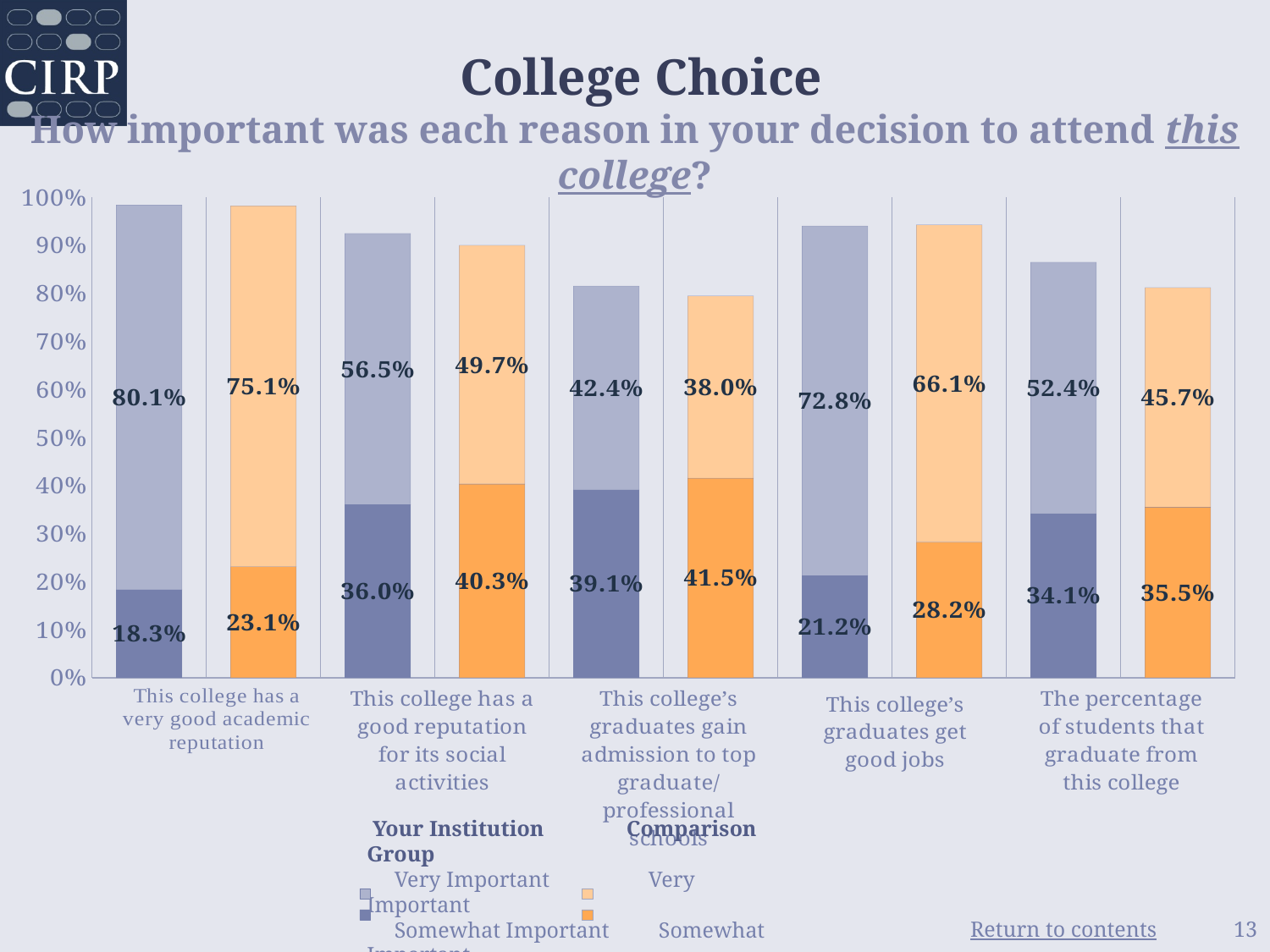
For 'This college has a good reputation for its social activities', which is larger: Your Institution's Very Important value or the Comparison Group's Very Important value? Your Institution What is the Comparison Group's Somewhat Important value for 'This college's graduates get good jobs'? 28.2% What kind of chart is shown on the slide? Stacked bar chart What is the Very Important value for Your Institution for 'The percentage of students that graduate from this college'? 52.4% Across the five reasons, which has the highest Very Important percentage for Your Institution? This college has a very good academic reputation What percentage of students at Your Institution rated 'This college has a very good academic reputation' as Very Important? 80.1% What is the total height of the Your Institution stacked bar for 'This college has a very good academic reputation'? 98.4% What is the difference between Your Institution's and the Comparison Group's Very Important values for 'This college's graduates get good jobs'? 6.7% What is the total of the Comparison Group stacked bar for 'This college's graduates gain admission to top graduate/professional schools'? 79.5% Which reason has the lowest Very Important percentage for the Comparison Group? This college's graduates gain admission to top graduate/professional schools How many reasons (categories) are shown on the x axis? 5 How many series does the legend list? 4